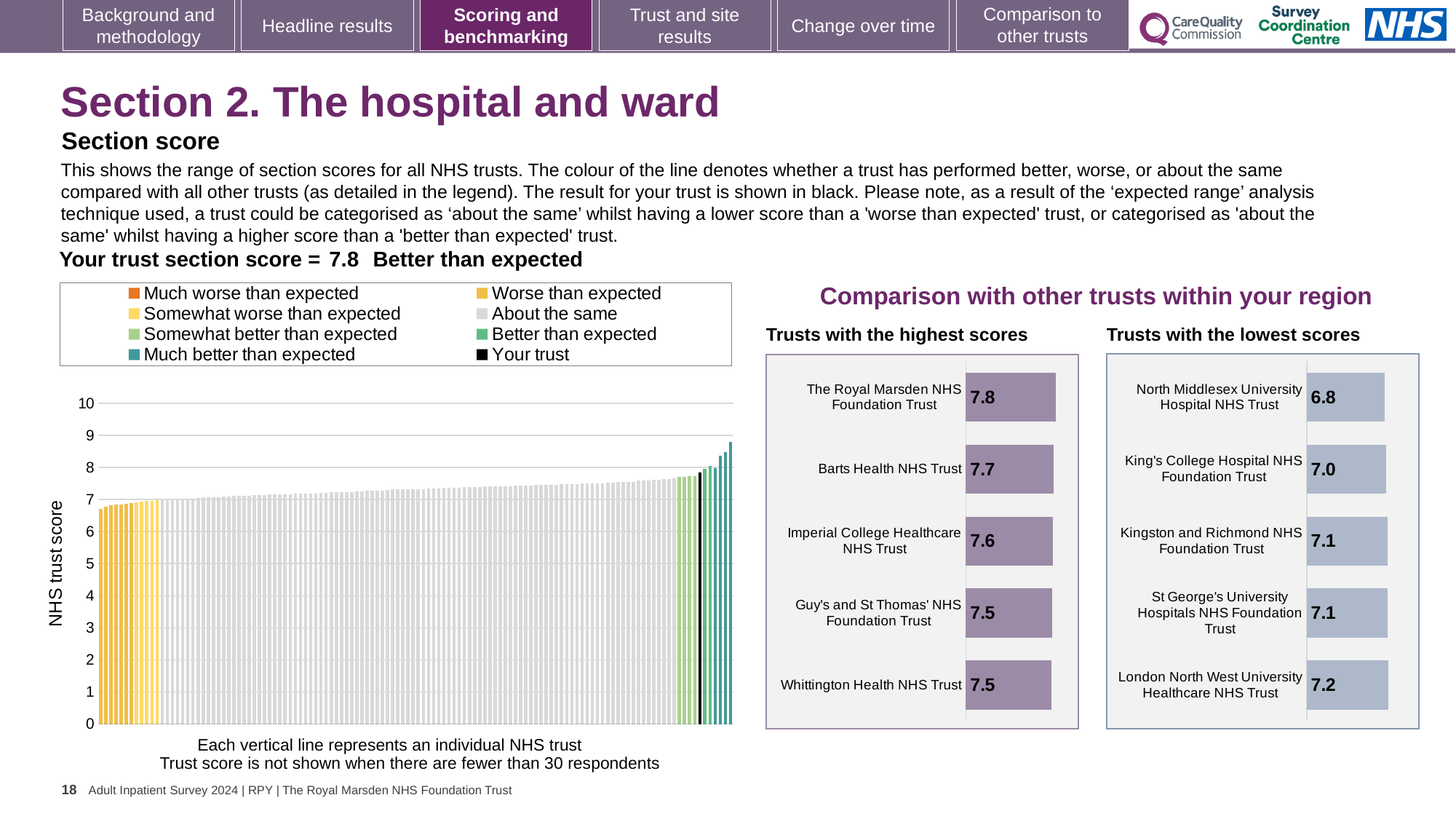
In the 'Trusts with the lowest scores' chart, what is the score for King's College Hospital NHS Foundation Trust? 7.0 What kind of chart is the large 'NHS trust score' chart on the left of the slide? Bar chart In the 'Trusts with the highest scores' chart, which has the larger score: Imperial College Healthcare NHS Trust or Guy's and St Thomas' NHS Foundation Trust? Imperial College Healthcare NHS Trust How many trusts are shown in the 'Trusts with the highest scores' chart? 5 In the 'Trusts with the lowest scores' chart, what is the score for North Middlesex University Hospital NHS Trust? 6.8 In the 'Trusts with the highest scores' chart, which trust has the highest score? The Royal Marsden NHS Foundation Trust In the 'Trusts with the highest scores' chart, what is the difference between the scores of The Royal Marsden NHS Foundation Trust and Whittington Health NHS Trust? 0.3 How many entries does the legend above the 'NHS trust score' chart list? 8 In the 'Trusts with the lowest scores' chart, how much higher is London North West University Healthcare NHS Trust's score than North Middlesex University Hospital NHS Trust's? 0.4 In the 'Trusts with the lowest scores' chart, which trust has the lowest score? North Middlesex University Hospital NHS Trust In the 'Trusts with the highest scores' chart, what is the score for Barts Health NHS Trust? 7.7 In the 'NHS trust score' chart, is the value of the tallest bar greater or less than 8? greater